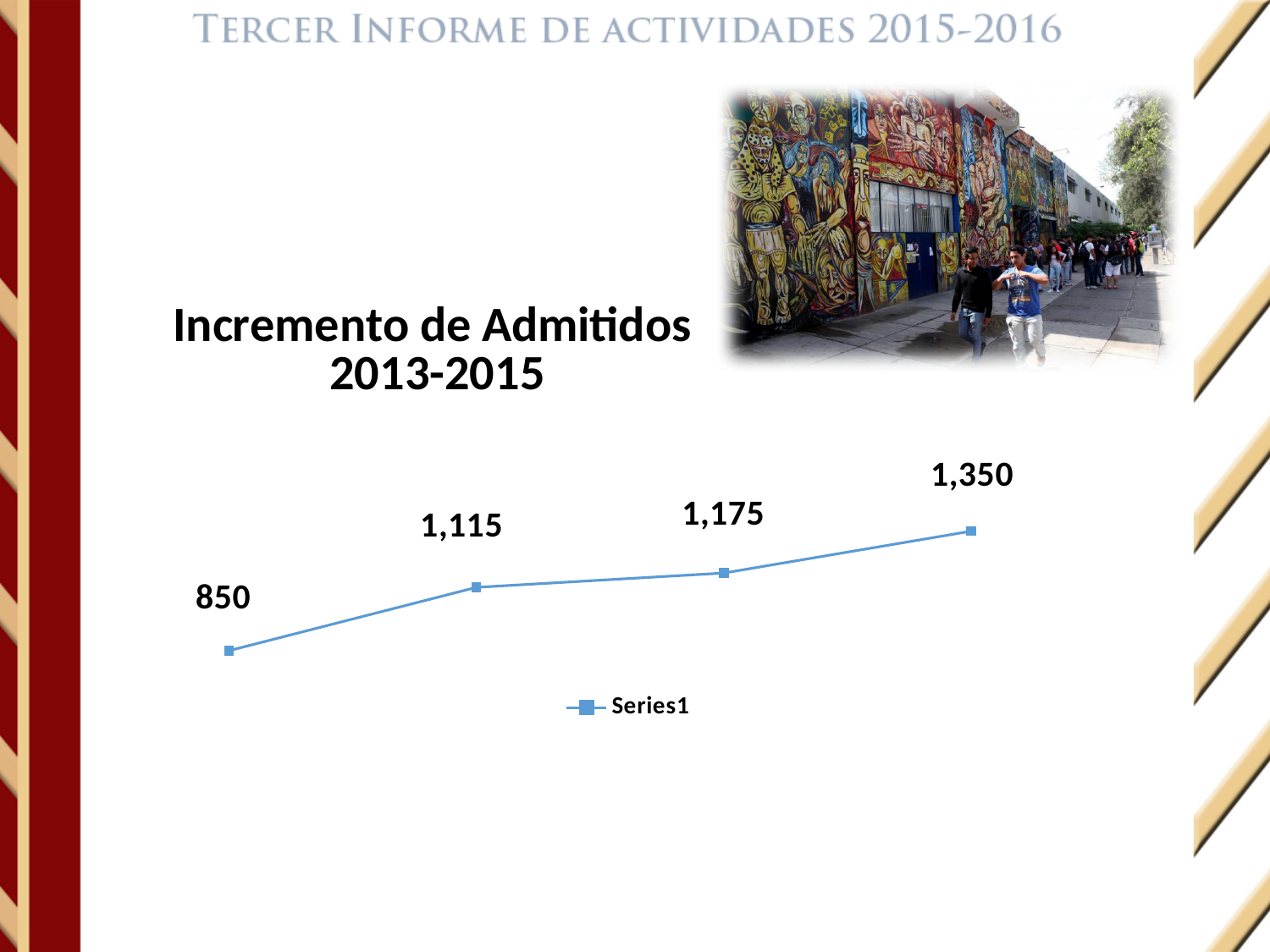
What kind of chart is shown on the slide? line chart What is the value of the first (leftmost) point on the line? 850 What is the value of the second point on the line? 1,115 Do the values rise or fall from left to right along the line? rise What is the value of the last (rightmost) point on the line? 1,350 What is the name of the series shown in the legend? Series1 How many series does the legend list? 1 What is the value of the third point on the line? 1,175 How many data points are plotted on the line chart? 4 What is the difference between the last point (1,350) and the first point (850)? 500 What is the lowest value plotted on the line chart? 850 What is the highest value plotted on the line chart? 1,350